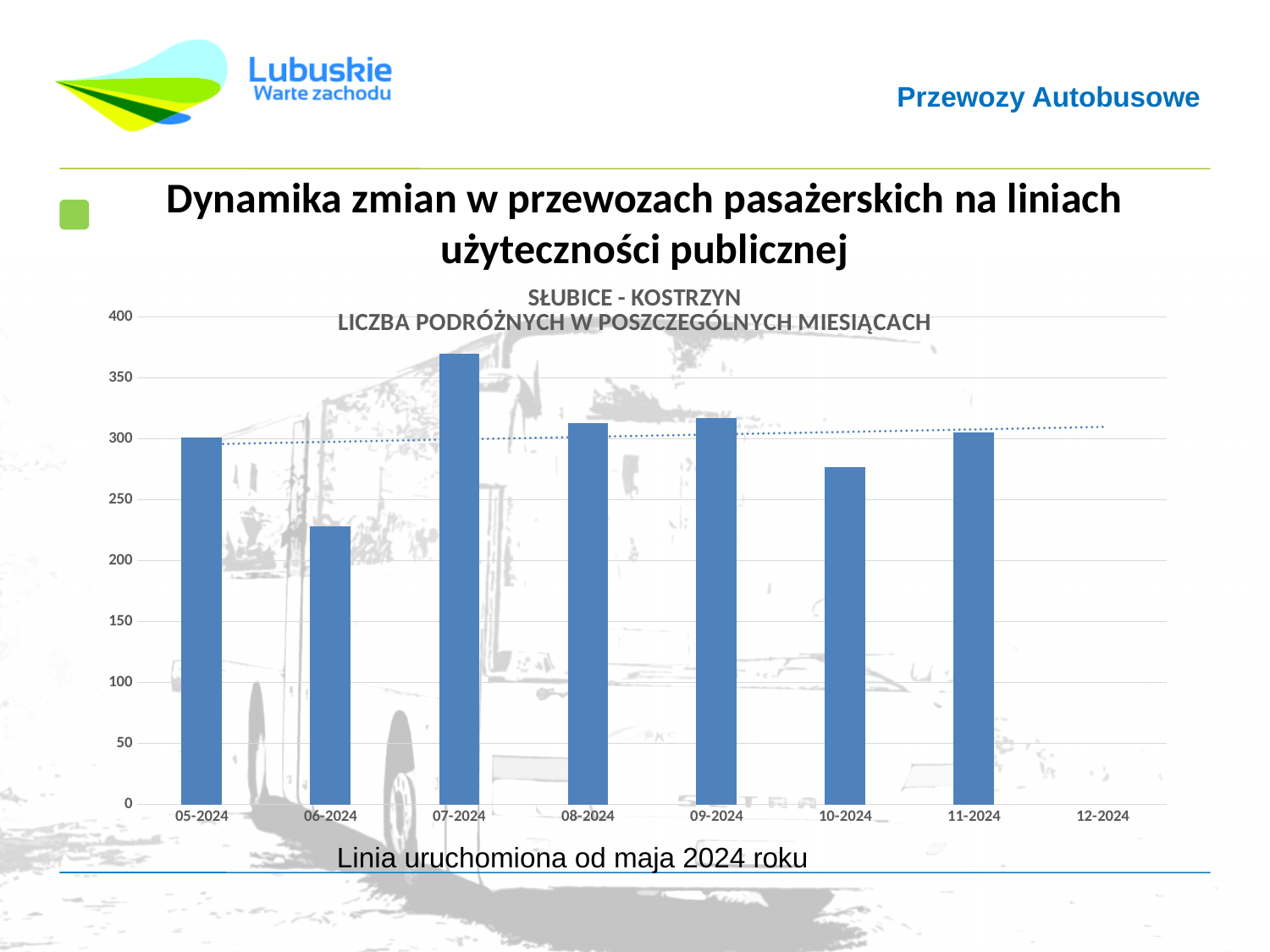
Is the value for 10-2024 greater or less than 300? less Which is larger, the value for 08-2024 or the value for 10-2024? 08-2024 Is the value for 07-2024 greater or less than 350? greater Which month has the lowest number of passengers? 06-2024 Which month has the highest number of passengers? 07-2024 Which bus line does the chart title refer to? SŁUBICE - KOSTRZYN How many months have a bar plotted on the chart? 7 Is the value for 06-2024 greater or less than 250? less What kind of chart is shown on the slide? bar chart Which is larger, the value for 06-2024 or the value for 11-2024? 11-2024 Do the values rise or fall from 09-2024 to 10-2024? fall